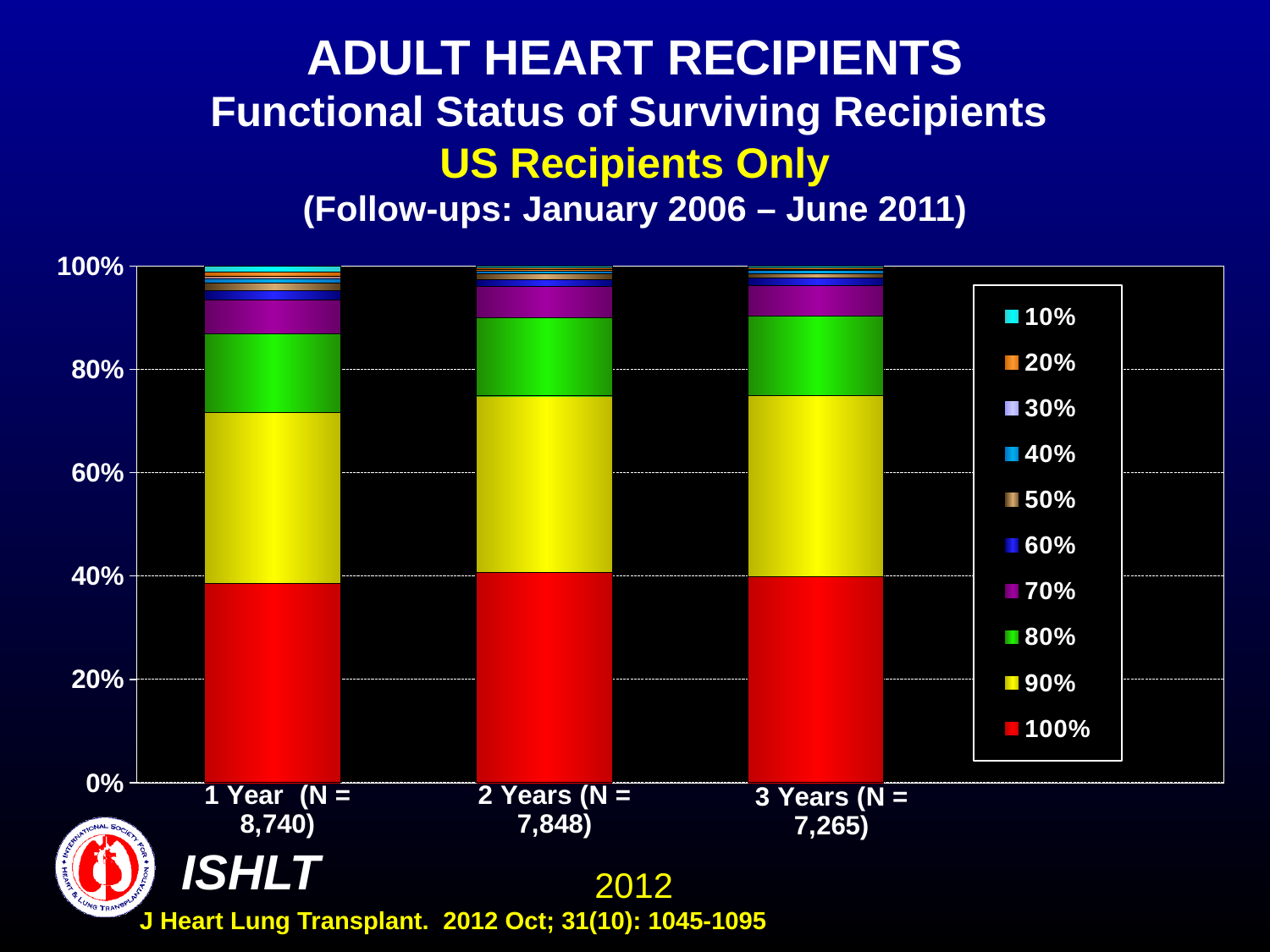
How many follow-up time categories are shown on the x axis? 3 Is the share of recipients at 100% functional status at 1 Year greater or less than 40%? less What is the N value shown for the 1 Year category? 8,740 Is the share of recipients at 80% functional status at 1 Year greater or less than 20%? less How many functional status series does the legend list? 10 Which functional status category makes up the largest share of the 1 Year bar? 100% What colour represents the 100% functional status series in the legend? red Which is larger in the 3 Years bar: the 90% segment or the 80% segment? 90% What kind of chart is shown on the slide? stacked bar chart Is the share of recipients at 90% functional status at 2 Years greater or less than 20%? greater